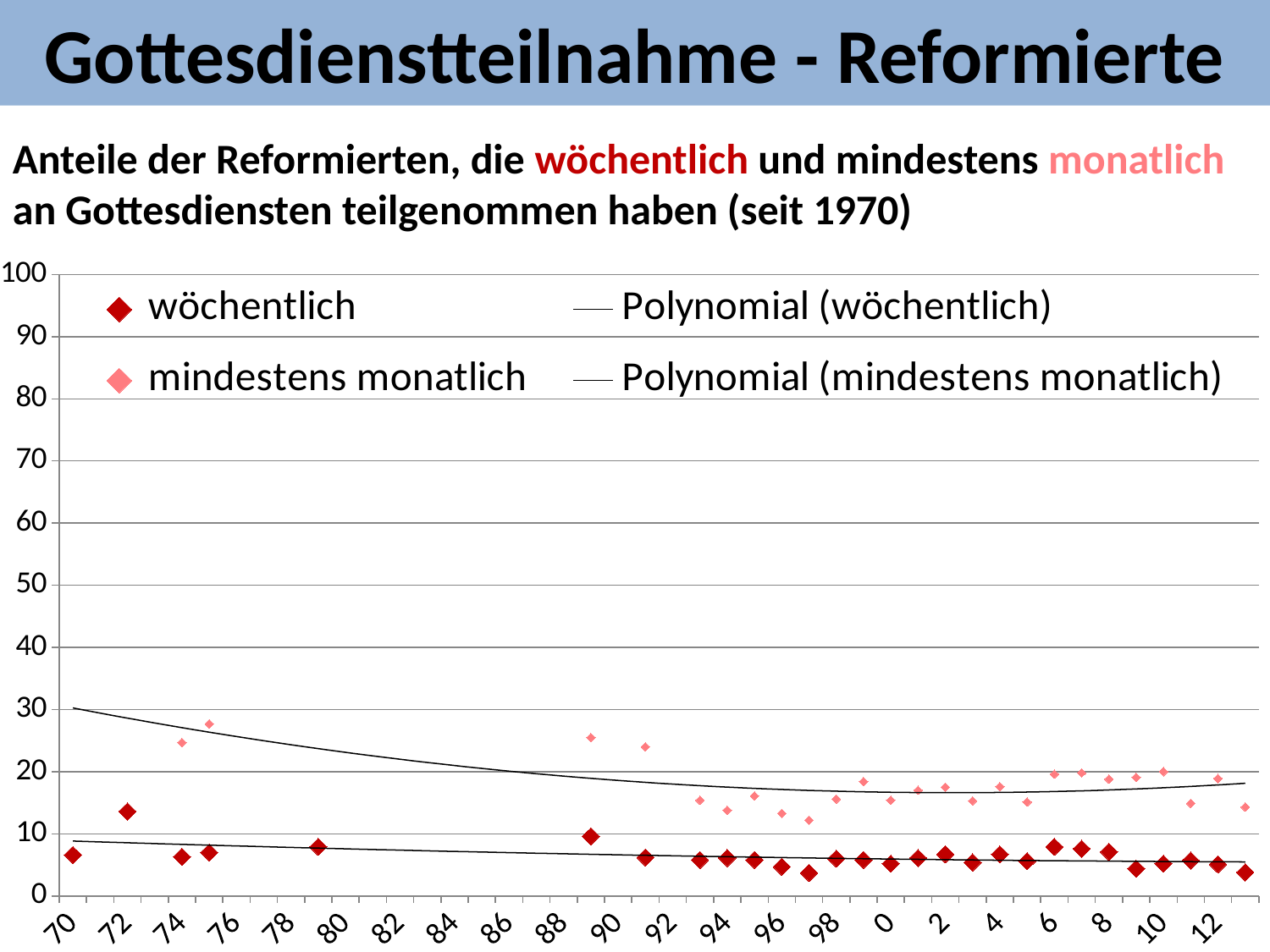
Is the value for mindestens monatlich in 1997 greater or less than 20? less Which series has the larger value in 1975, wöchentlich or mindestens monatlich? mindestens monatlich Is the value for wöchentlich in 1970 greater or less than 10? less Is the value for wöchentlich in 1972 greater or less than 10? greater What is the highest value shown on the vertical axis? 100 Which colour marks the wöchentlich series in the legend? dark red How many entries does the chart legend list? 4 What kind of chart is shown on the slide? scatter chart Does the polynomial trendline for mindestens monatlich rise or fall between 1970 and 1990? fall